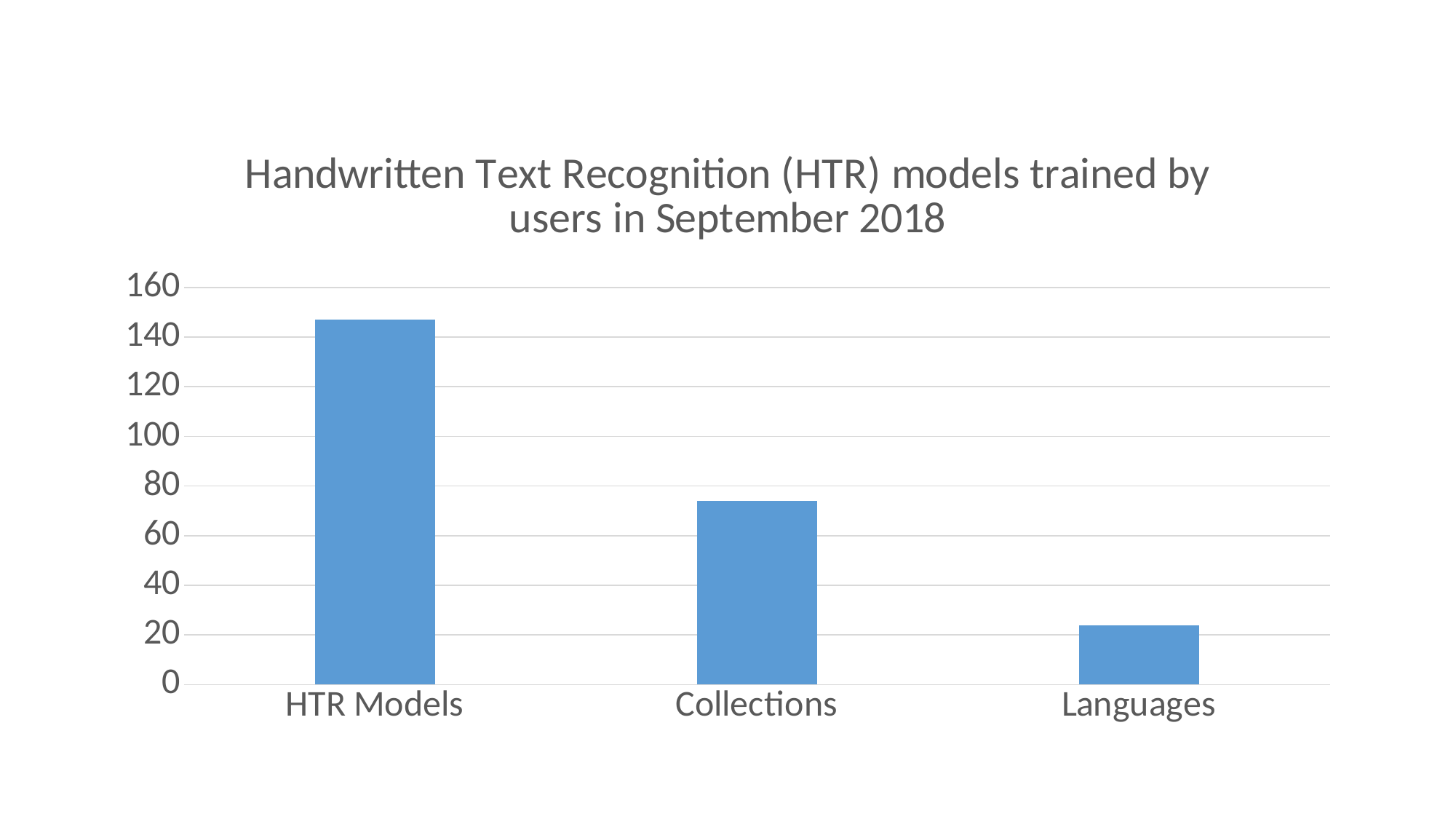
Which category has the lowest value? Languages Which category has the highest value? HTR Models How many categories are shown on the x axis? 3 Which is larger, the value for HTR Models or the value for Collections? HTR Models What is the title of the chart? Handwritten Text Recognition (HTR) models trained by users in September 2018 What kind of chart is shown on the slide? bar chart Is the value for Languages greater or less than 40? less Is the value for Collections greater or less than 60? greater What is the highest value shown on the vertical axis? 160 Is the value for HTR Models greater or less than 140? greater Which is larger, the value for Collections or the value for Languages? Collections